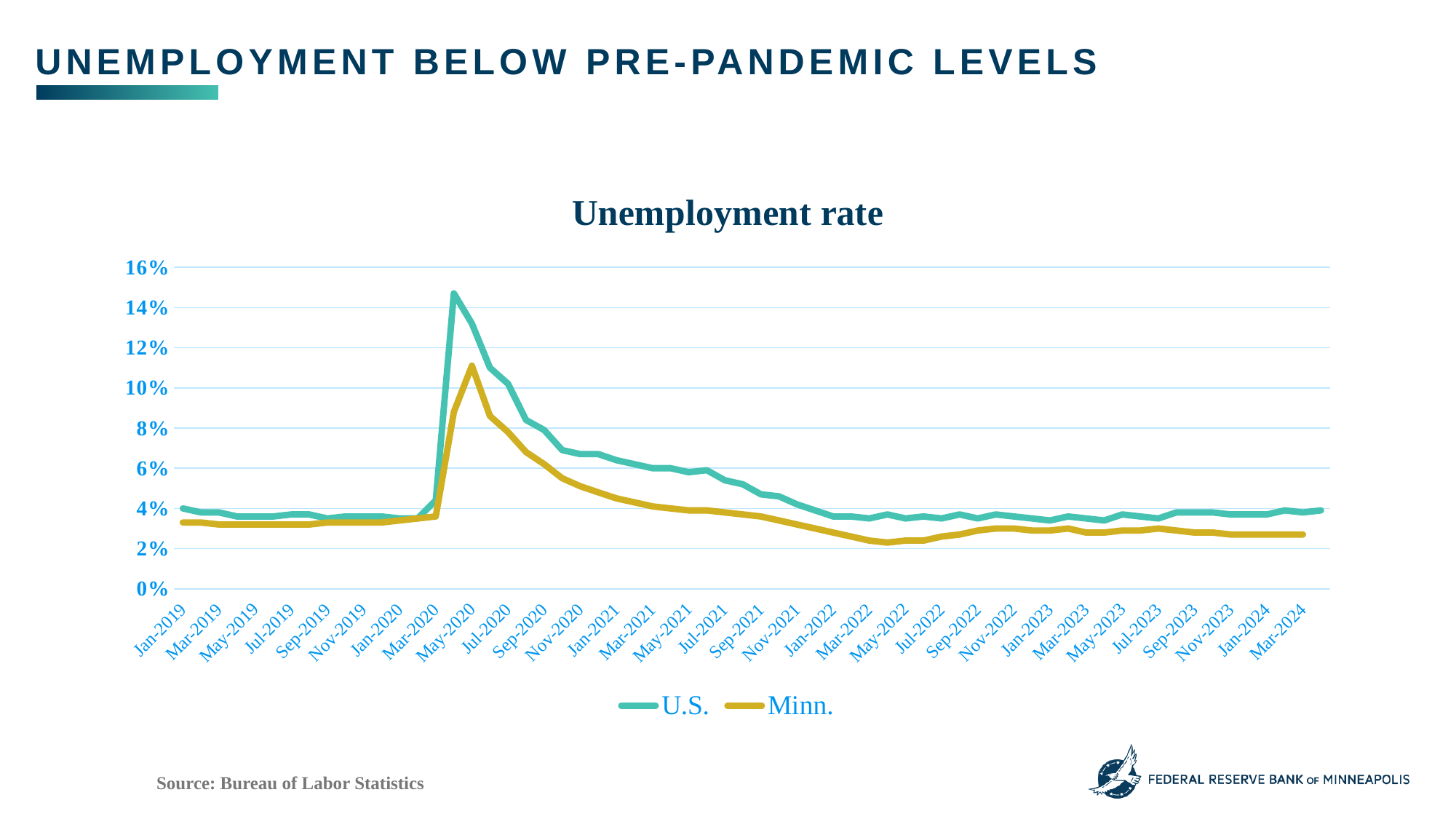
What is the title of the chart? Unemployment rate Is the peak value of the U.S. series greater or less than 12%? greater Between May-2020 and Jan-2022, does the U.S. series rise or fall? fall Is the U.S. value in Jan-2019 greater or less than 2%? greater What are the two series named in the legend? U.S. and Minn. In Mar-2024, which series has the higher value, U.S. or Minn.? U.S. Is the peak value of the Minn. series greater or less than 10%? greater How many series does the legend list? 2 What kind of chart is shown on the slide? line chart Which series reaches the lowest value on the chart? Minn. Which series reaches the highest value on the chart? U.S.